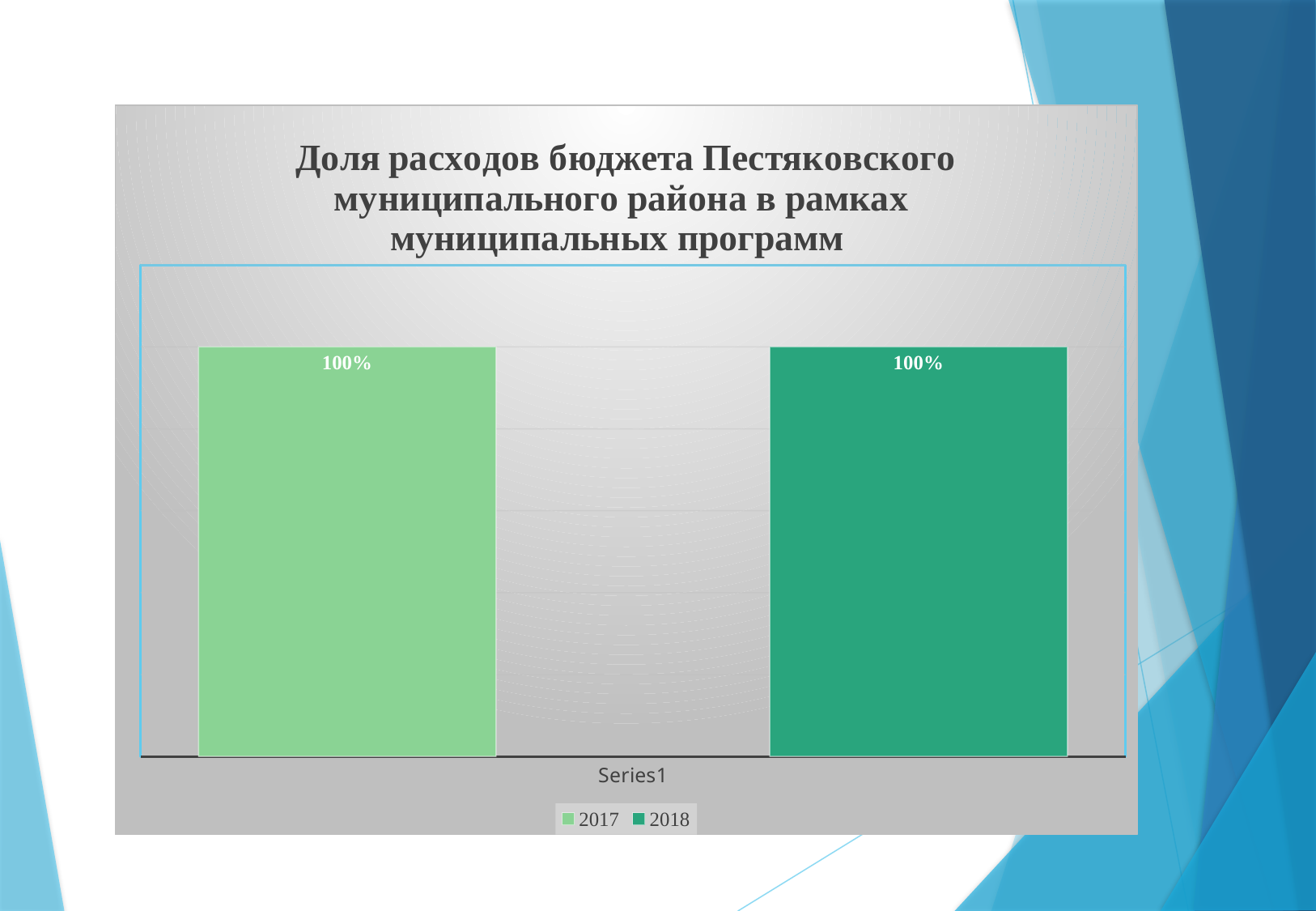
What type of chart is shown on the slide? bar chart What is the category label shown on the x axis? Series1 What is the value for 2017? 100% How many series does the legend list? 2 What is the difference between the values for 2017 and 2018? 0% How many bars are plotted on the chart? 2 Which series is shown in the lighter green colour? 2017 Does the value change from 2017 to 2018? No, it stays at 100% What is the value for 2018? 100%